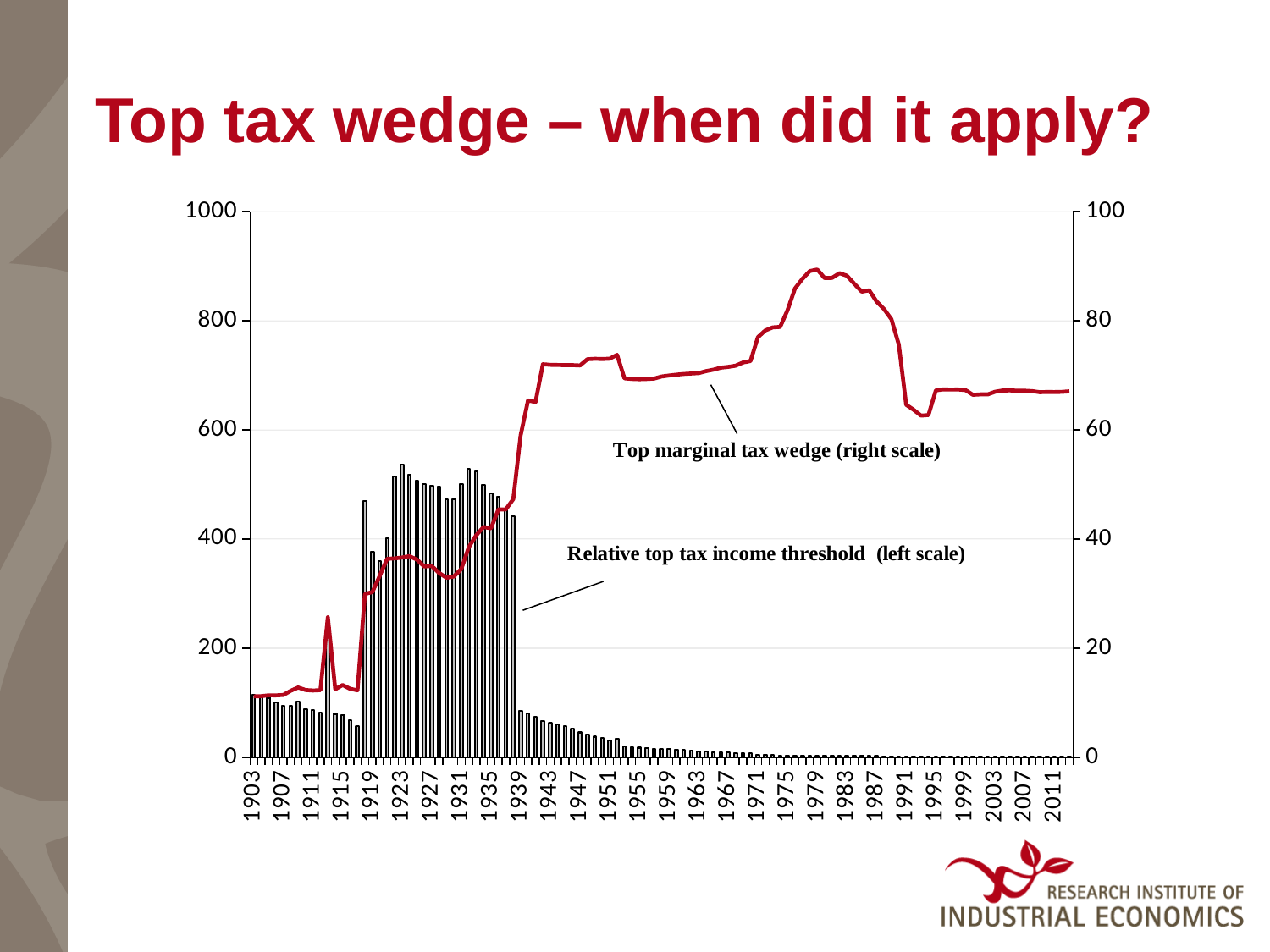
Is the value of the top marginal tax wedge in 1979 greater or less than 80? greater Is the relative top tax income threshold bar for 1923 greater or less than 400? greater Which series is plotted against the right scale? Top marginal tax wedge What is the title of the slide? Top tax wedge – when did it apply? Is the relative top tax income threshold bar for 1947 greater or less than 200? less Do the relative top tax income threshold bars rise or fall from 1943 to 2011? fall How many data series are plotted on the chart? 2 Which is larger, the top marginal tax wedge in 1979 or in 1991? 1979 What kind of chart is shown on the slide? A combined bar and line chart Which is larger, the relative top tax income threshold in 1923 or in 1947? 1923